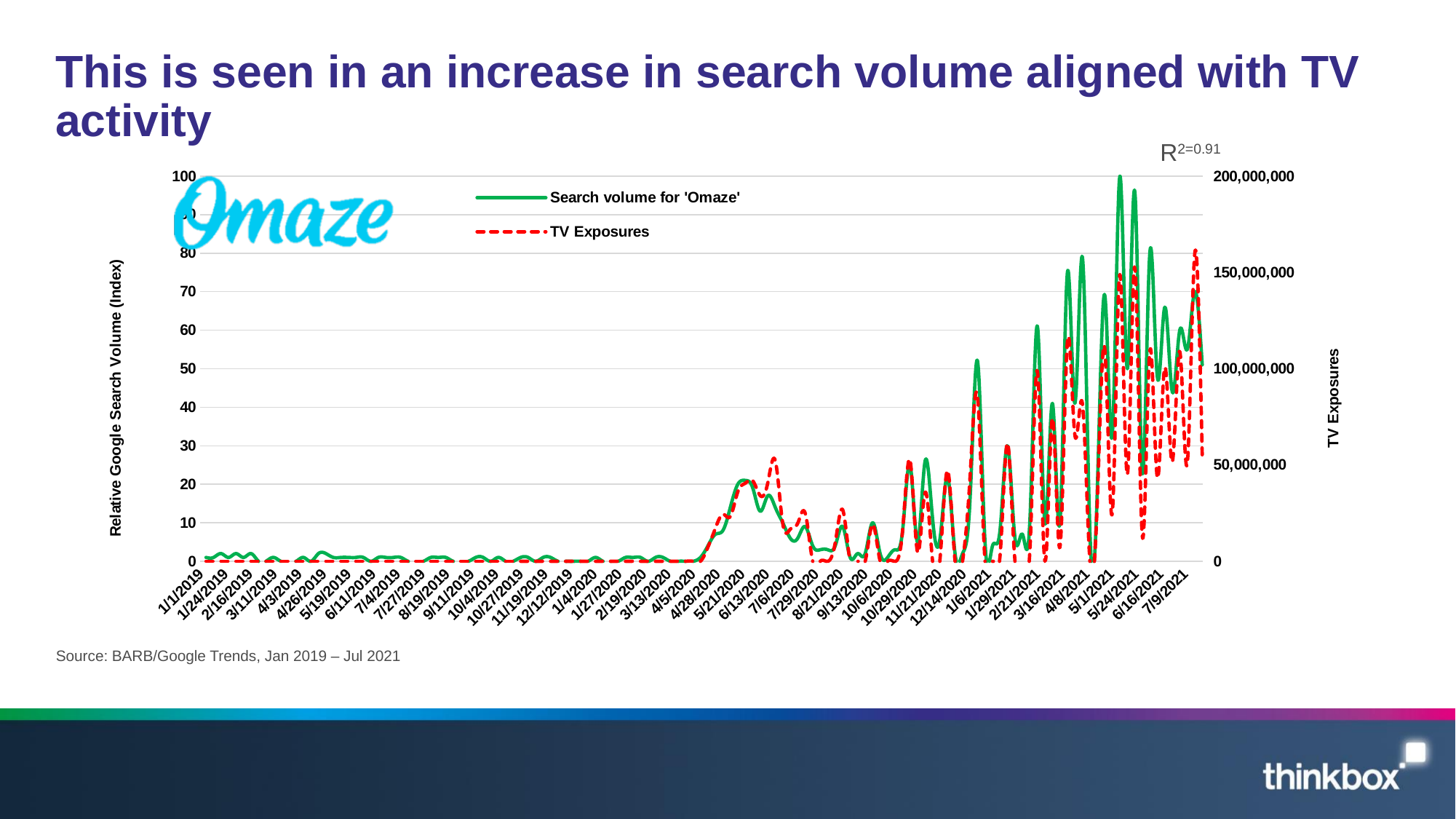
Is the highest peak of the search volume for 'Omaze' series greater or less than 90? greater Is the search volume for 'Omaze' around 5/21/2020 greater or less than 30? less Is the search volume for 'Omaze' around 5/21/2020 greater or less than 10? greater Which series is drawn as a red dashed line? TV Exposures What R-squared value is shown above the chart? R2=0.91 What are the two series named in the chart's legend? Search volume for 'Omaze' and TV Exposures How many series does the chart's legend list? 2 What kind of chart is shown on the slide? Line chart Overall, does the search volume for 'Omaze' rise or fall from January 2019 to July 2021? Rise